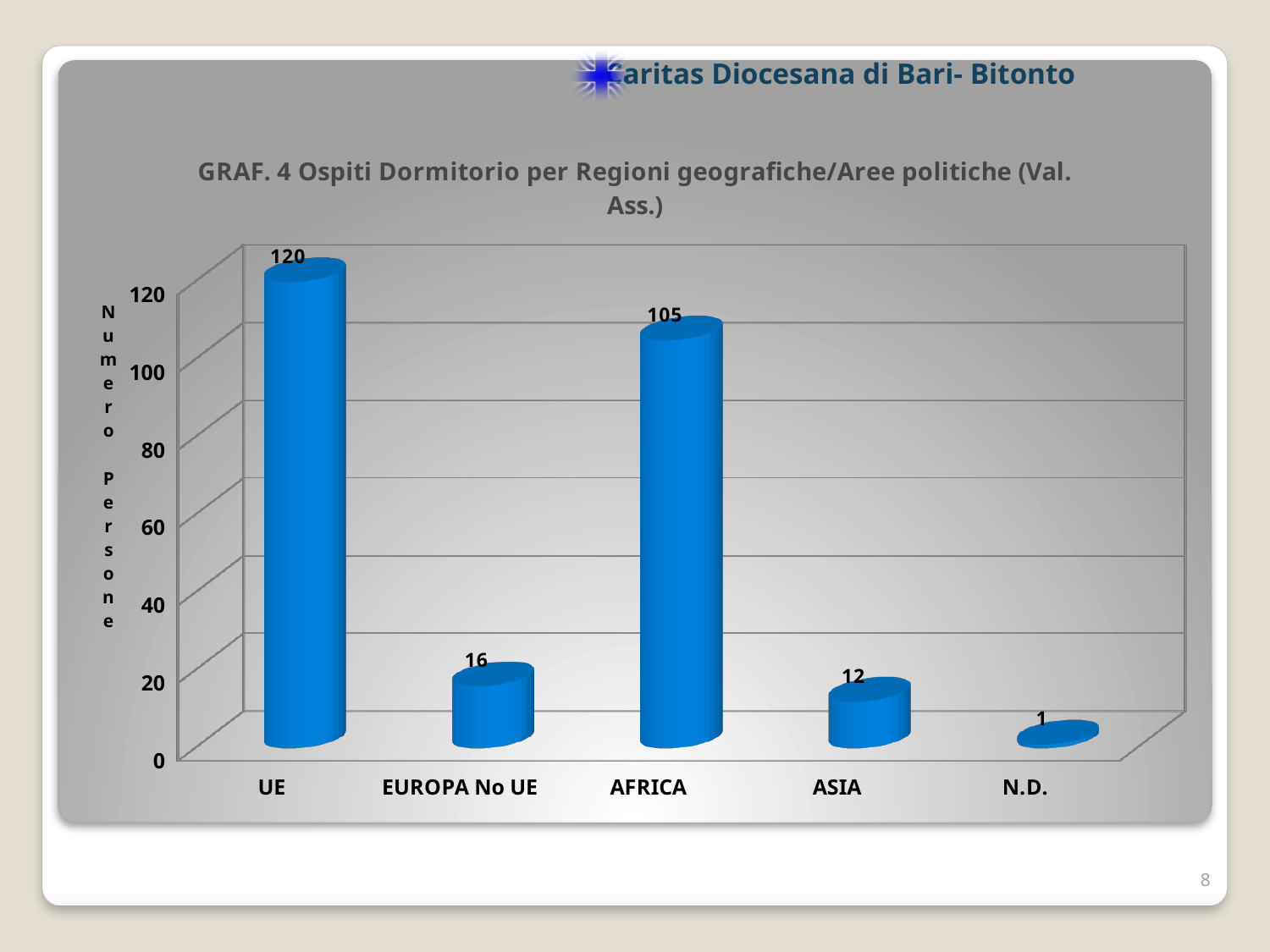
What is the value for UE? 120 What is the difference between the values for UE and AFRICA? 15 What is the label of the vertical axis? Numero Persone How many categories are shown on the x axis? 5 Which category has the highest value? UE What is the value for AFRICA? 105 What is the value for ASIA? 12 Which category has the lowest value? N.D. What is the value for EUROPA No UE? 16 What kind of chart is shown on the slide? bar chart Which is larger, the value for EUROPA No UE or the value for ASIA? EUROPA No UE What is the value for N.D.? 1